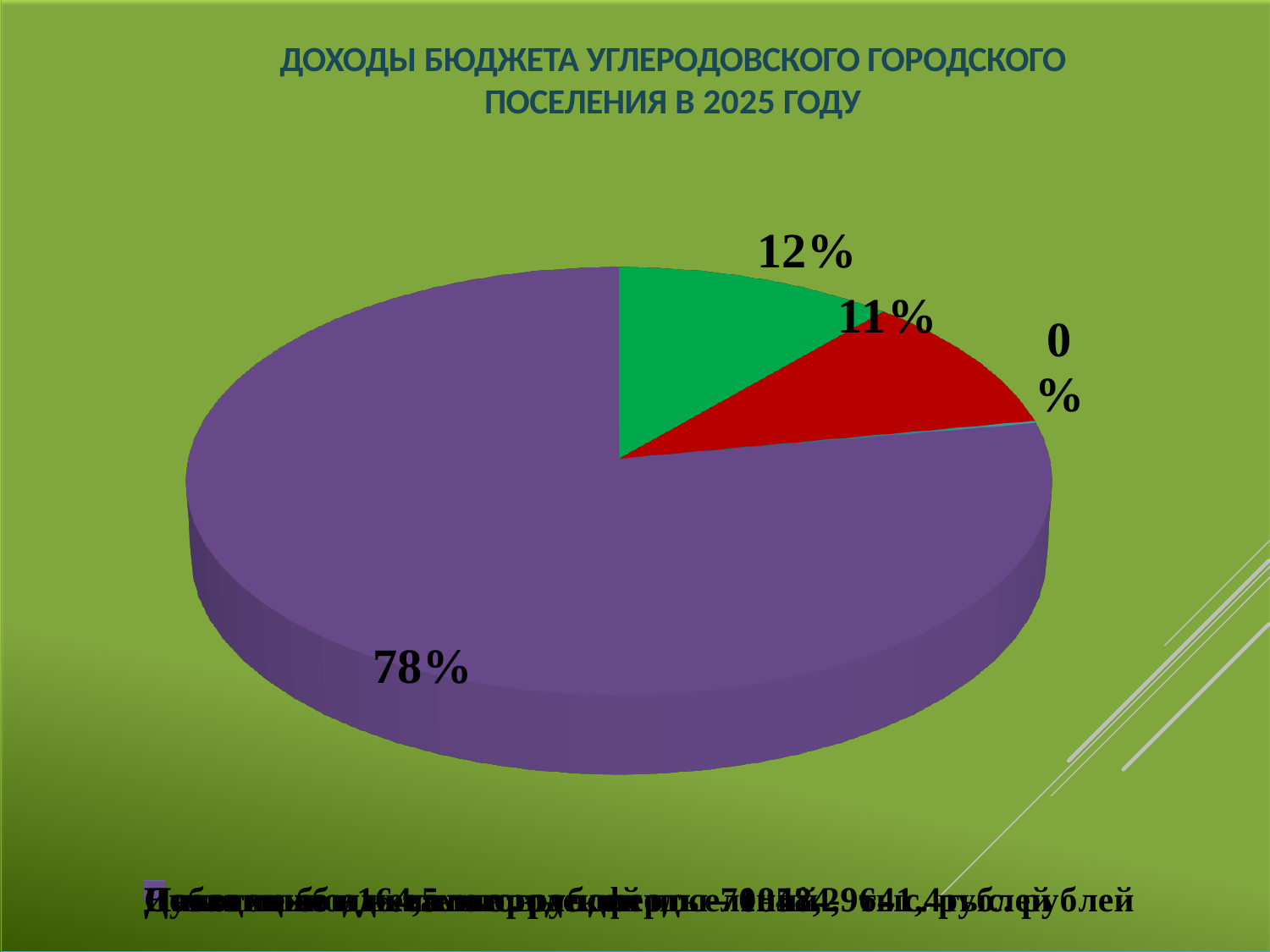
What is the smallest share shown on the pie chart? 0% What share of the pie does the green slice represent? 12% What is the largest share shown on the pie chart? 78% How many percentage labels are shown on the pie chart? 4 What is the difference in percentage points between the purple slice (78%) and the green slice (12%)? 66 Which slice is larger, the green one or the red one? green What kind of chart is shown on the slide? pie chart What share of the pie does the purple slice represent? 78% What is the title of the chart? ДОХОДЫ БЮДЖЕТА УГЛЕРОДОВСКОГО ГОРОДСКОГО ПОСЕЛЕНИЯ В 2025 ГОДУ What is the difference in percentage points between the green slice (12%) and the red slice (11%)? 1 What share of the pie does the red slice represent? 11% What colour is the largest slice of the pie chart? purple